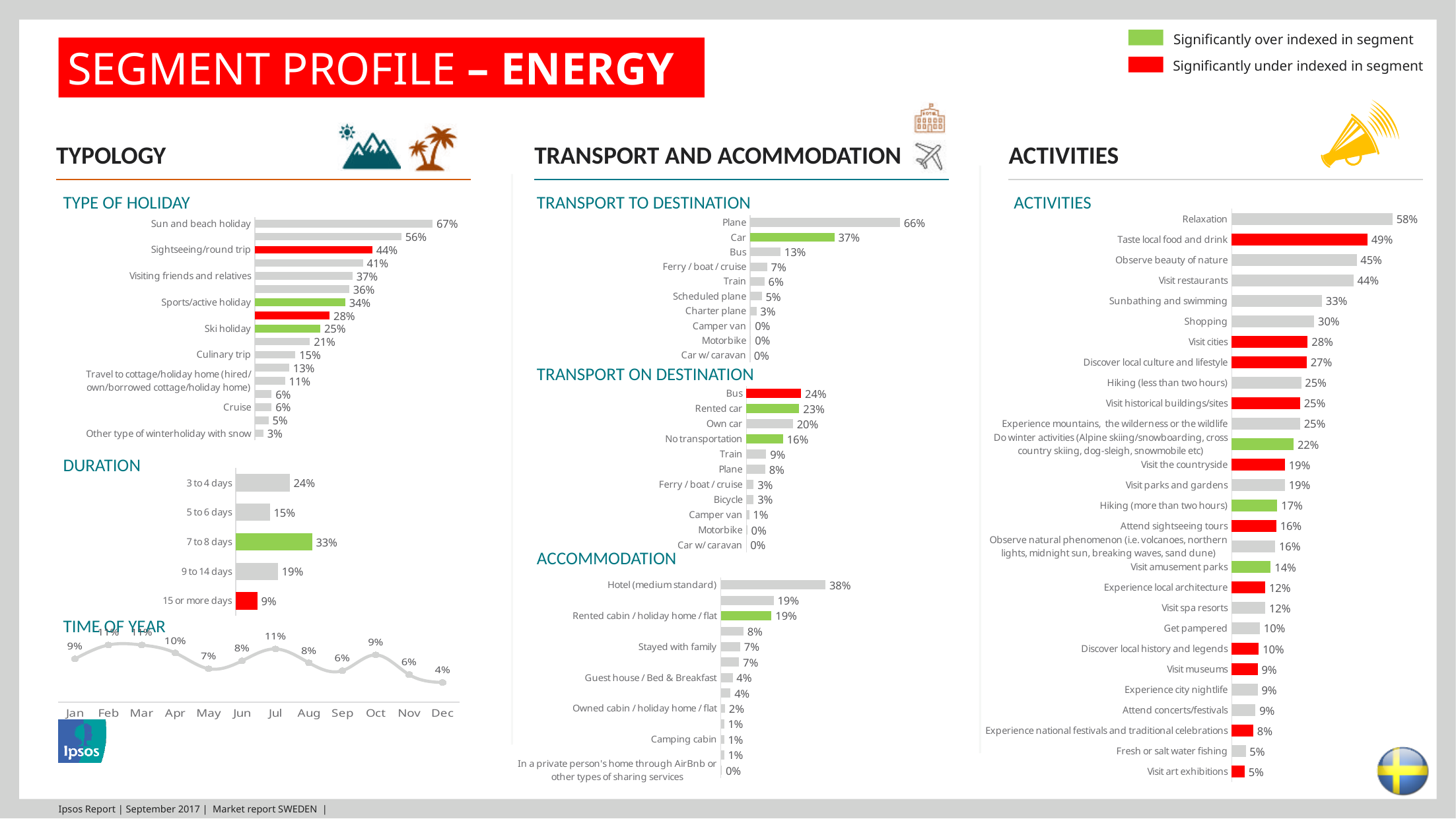
What kind of chart is the Time of Year chart? Line chart In the Type of Holiday chart, what percentage is shown for Sun and beach holiday? 67% In the Duration chart, which duration has the highest percentage? 7 to 8 days In the Time of Year chart, which month has the lowest value? Dec In the Transport to Destination chart, what percentage is shown for Car? 37% In the Activities chart, which activity has the highest percentage? Relaxation In the Time of Year chart, what value is shown for Jul? 11% In the Transport on Destination chart, which is larger: Bus or Own car? Bus How many categories does the Transport on Destination chart show? 11 In the Accommodation chart, what percentage is shown for Hotel (medium standard)? 38% In the Type of Holiday chart, what is the difference between Sightseeing/round trip and Ski holiday? 19 percentage points In the Duration chart, what percentage is shown for 15 or more days? 9%